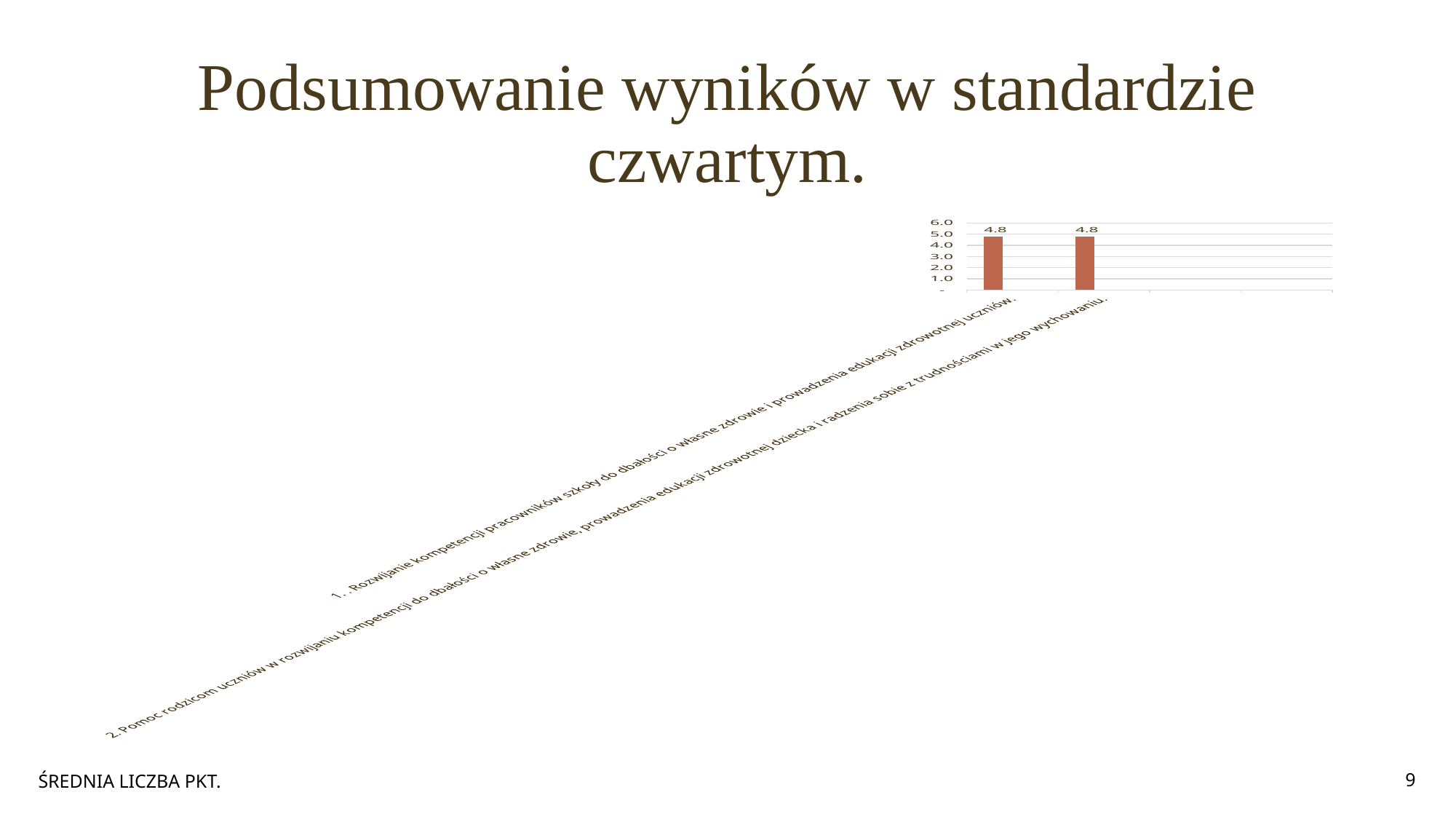
How many bars are plotted in the chart? 2 Do the values rise, fall, or stay the same from category 1 to category 2? stay the same What is the difference between the values for category 1 and category 2? 0.0 What kind of chart is shown on the slide? bar chart Is the value for category 2 greater or less than 5.0? less What is the value for category 2 (Pomoc rodzicom uczniów...)? 4.8 What is the highest value shown on the vertical axis? 6.0 What is the value for category 1 (Rozwijanie kompetencji pracowników szkoły...)? 4.8 Which category has the larger value, category 1 or category 2? They are equal (both 4.8) Is the value for category 1 greater or less than 4.0? greater